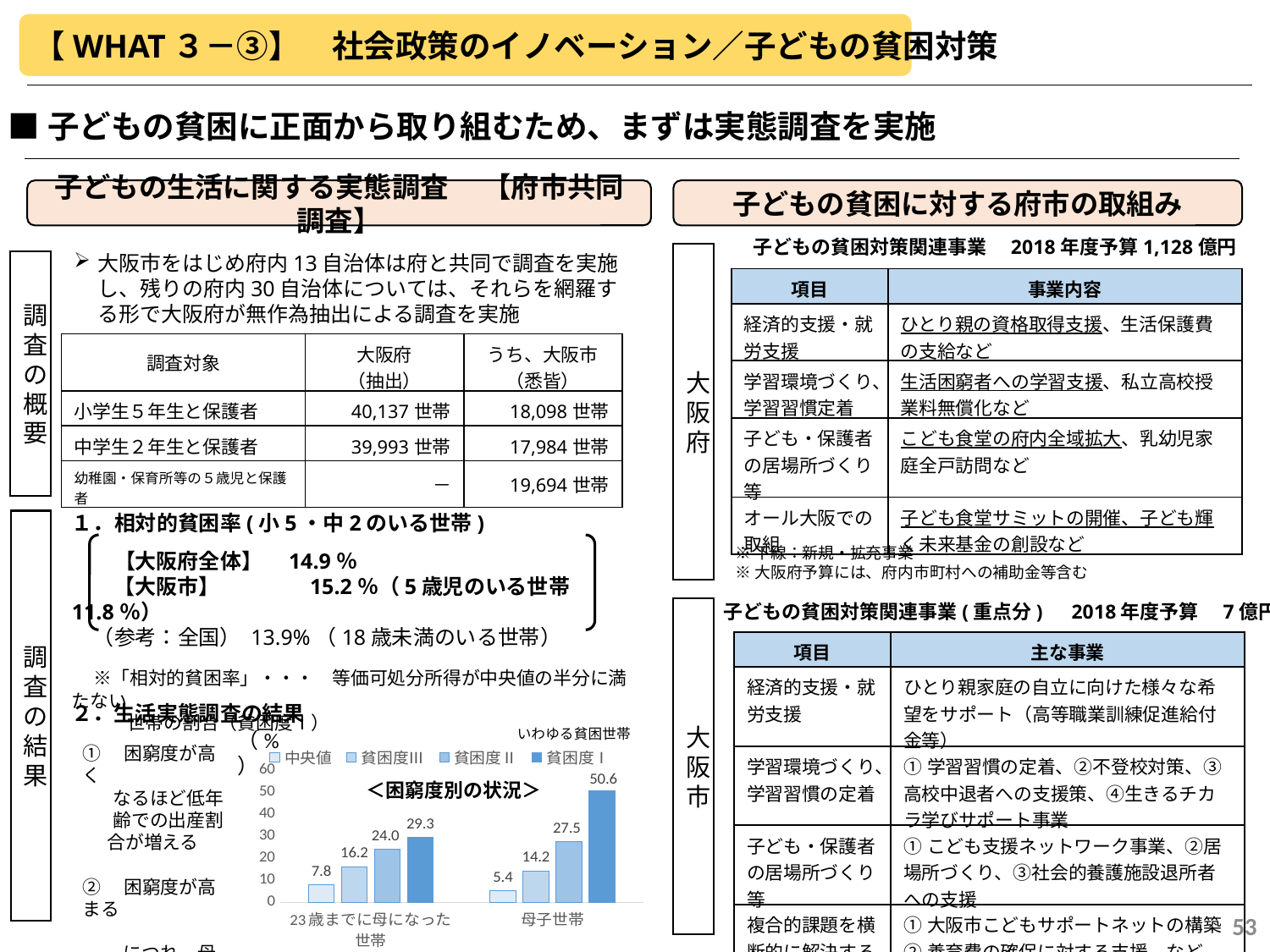
In the ＜困窮度別の状況＞ chart, which series has the lowest value in the 23歳までに母になった世帯 category? 中央値 In the ＜困窮度別の状況＞ chart, what is the difference between 貧困度Ⅰ and 中央値 in the 母子世帯 category? 45.2 How many categories are shown on the x axis of the ＜困窮度別の状況＞ chart? 2 In the ＜困窮度別の状況＞ chart, which is larger: 貧困度Ⅰ for 23歳までに母になった世帯 or 貧困度Ⅰ for 母子世帯? 母子世帯 In the ＜困窮度別の状況＞ chart, what is the value for 中央値 in the 23歳までに母になった世帯 category? 7.8 In the ＜困窮度別の状況＞ chart, is the value for 貧困度Ⅰ in the 母子世帯 category greater or less than 40? greater In the ＜困窮度別の状況＞ chart, which series has the highest value in the 母子世帯 category? 貧困度Ⅰ In the ＜困窮度別の状況＞ chart, what is the value for 貧困度Ⅱ in the 23歳までに母になった世帯 category? 24.0 In the ＜困窮度別の状況＞ chart, what is the value for 貧困度Ⅲ in the 母子世帯 category? 14.2 What kind of chart is shown under ＜困窮度別の状況＞? bar chart How many series does the legend of the ＜困窮度別の状況＞ chart list? 4 In the ＜困窮度別の状況＞ chart, what is the value for 貧困度Ⅰ in the 母子世帯 category? 50.6